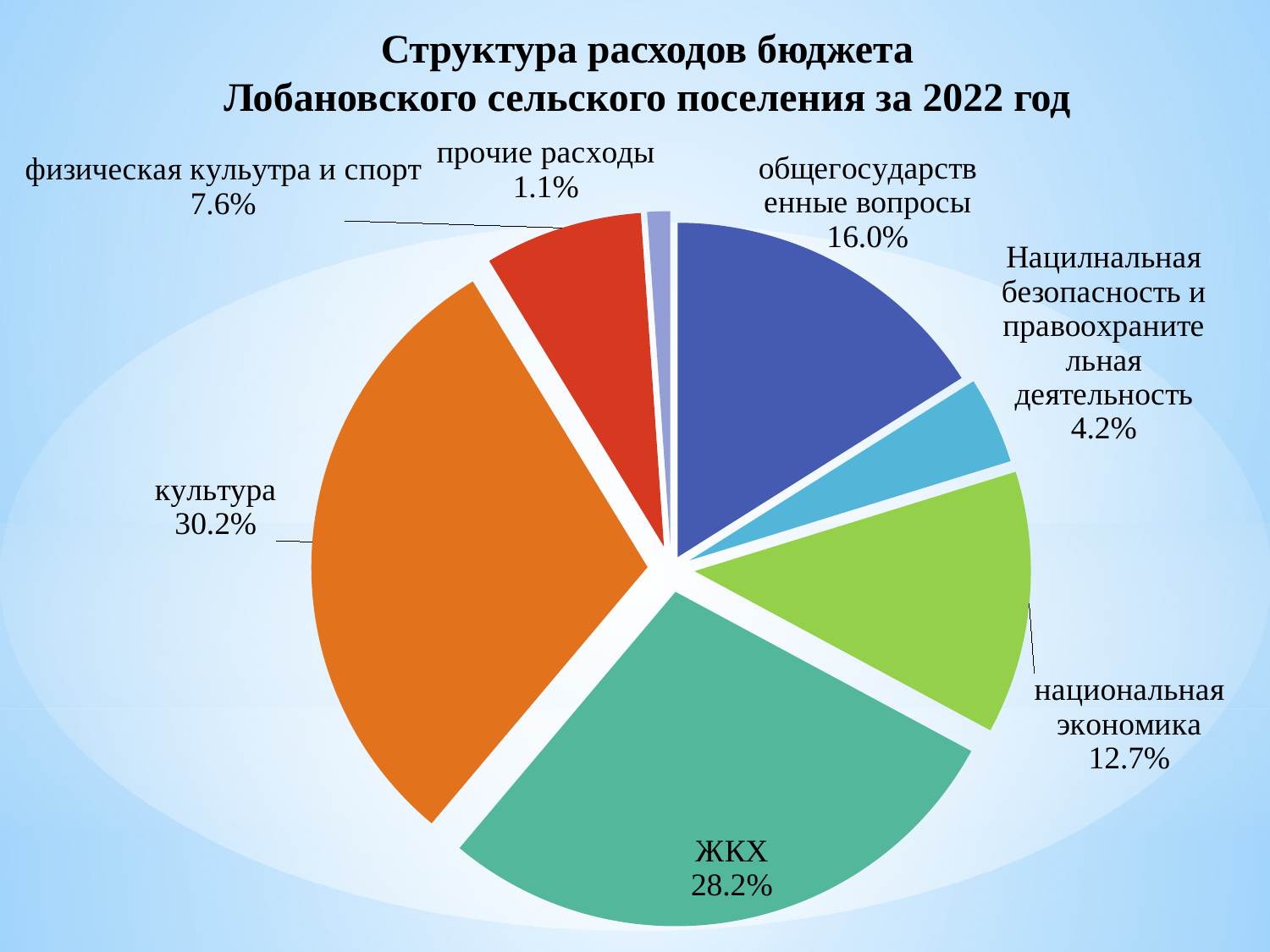
Which is larger: the share for общегосударственные вопросы or the share for национальная экономика? общегосударственные вопросы Which category has the smallest share of the pie? прочие расходы What is the difference between the shares of культура and ЖКХ? 2.0% What is the value shown for общегосударственные вопросы? 16.0% What kind of chart is shown on the slide? pie chart Which category has the largest share of the pie? культура What is the title of the chart? Структура расходов бюджета Лобановского сельского поселения за 2022 год How many categories (slices) does the pie chart have? 7 What share of budget expenditure goes to ЖКХ? 28.2% What is the value shown for прочие расходы? 1.1% What is the value shown for национальная экономика? 12.7% What share of budget expenditure goes to культура? 30.2%